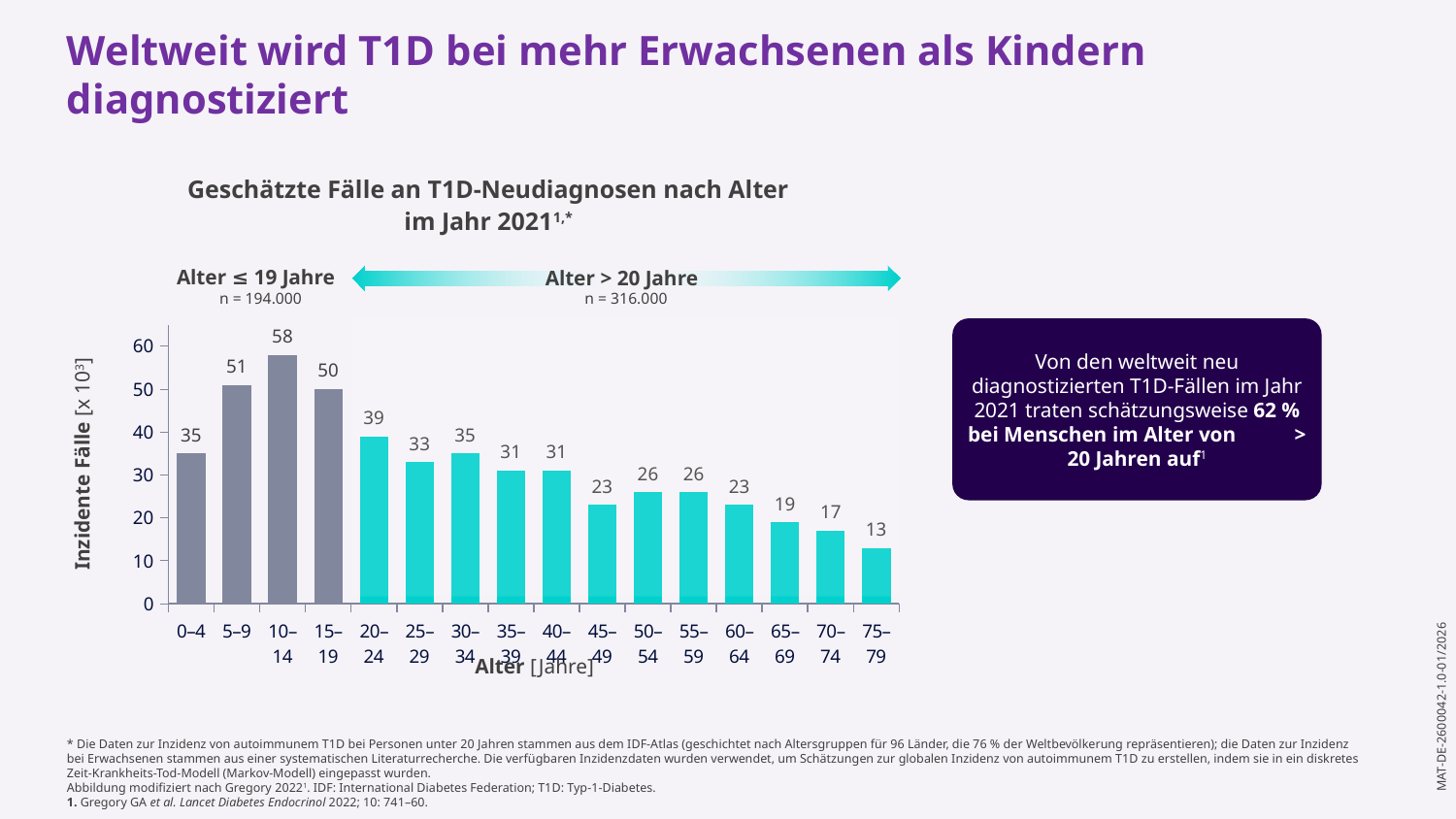
What is the difference between the values for the 10–14 and 15–19 age groups? 8 Is the value for the 45–49 age group greater or less than 30? less Which age group has the highest value? 10–14 What is the value for the 10–14 age group? 58 Which is larger, the value for 5–9 or the value for 20–24? 5–9 What is the value for the 20–24 age group? 39 Which age group has the lowest value? 75–79 What is the n value given for the group 'Alter > 20 Jahre'? n = 316.000 How many age groups are shown on the x axis? 16 What kind of chart is shown on the slide? bar chart What is the value for the 75–79 age group? 13 Do the values rise or fall from the 20–24 age group to the 75–79 age group? fall